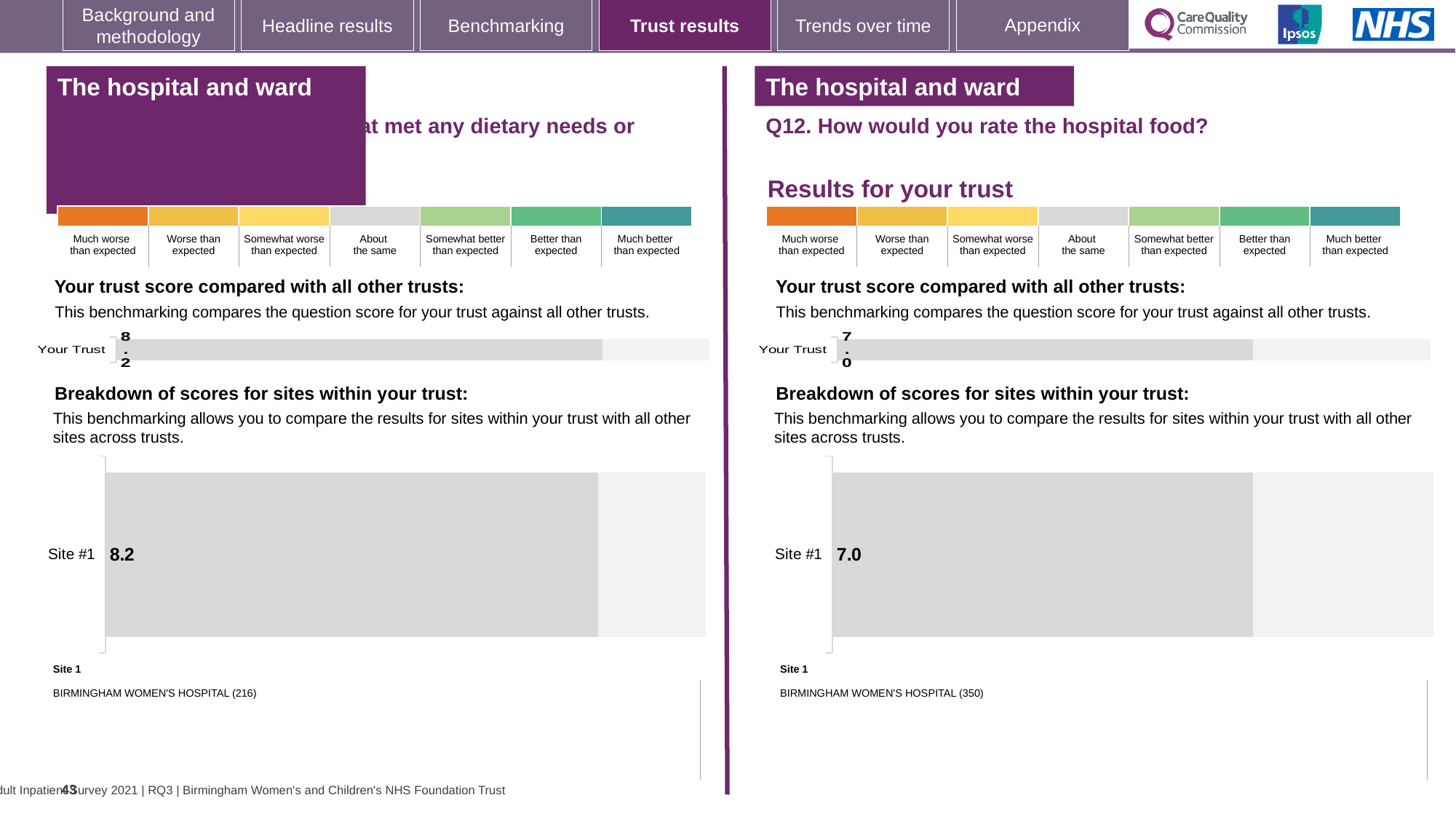
On the left-hand 'Breakdown of scores for sites within your trust' chart, what is the score for Site #1? 8.2 On the right-hand chart for Q12 (How would you rate the hospital food?), what is the score shown for Your Trust? 7.0 On the right-hand 'Breakdown of scores for sites within your trust' chart for Q12, what is the score for Site #1? 7.0 Which is larger: the Site #1 score on the left-hand breakdown chart or the Site #1 score on the right-hand Q12 breakdown chart? Left-hand chart (8.2) What is the difference between the Site #1 score on the left-hand breakdown chart (8.2) and the Site #1 score on the right-hand Q12 breakdown chart (7.0)? 1.2 How many sites are plotted on the left-hand 'Breakdown of scores for sites within your trust' chart? 1 On the left-hand breakdown chart, which site is labelled as Site 1? BIRMINGHAM WOMEN'S HOSPITAL (216) What kind of chart is used for the 'Breakdown of scores for sites within your trust' on the right-hand side for Q12? Bar chart On the left-hand 'Your trust score compared with all other trusts' chart, what is the score shown for Your Trust? 8.2 Is the Your Trust score on the right-hand Q12 chart equal to the Site #1 score on the right-hand Q12 breakdown chart? Yes, both are 7.0 How many sites are plotted on the right-hand 'Breakdown of scores for sites within your trust' chart for Q12? 1 On the right-hand Q12 breakdown chart, which site is labelled as Site 1? BIRMINGHAM WOMEN'S HOSPITAL (350)